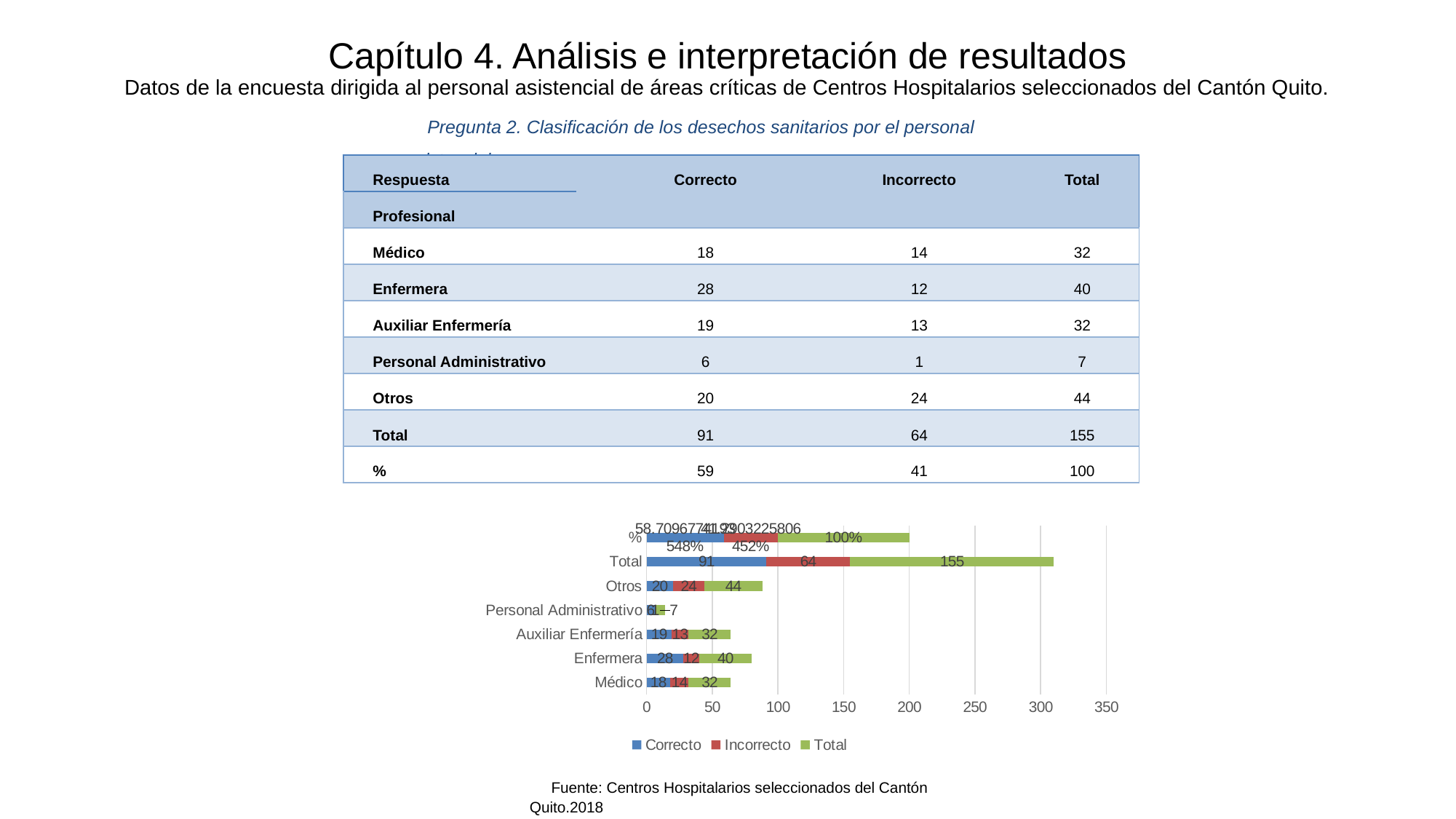
How many series does the chart legend list? 3 Which is larger in the chart: the Incorrecto value for Otros or the Incorrecto value for Médico? Otros What is the difference between the Correcto and Incorrecto values for Enfermera in the chart? 16 Among Médico, Enfermera, Auxiliar Enfermería, Personal Administrativo and Otros, which category has the lowest Correcto value in the chart? Personal Administrativo What is the Total value for Auxiliar Enfermería in the chart? 32 What is the Correcto value for the Total category in the chart? 91 What kind of chart is shown on the slide? bar chart What is the Incorrecto value for Otros in the chart? 24 Among Médico, Enfermera, Auxiliar Enfermería, Personal Administrativo and Otros, which category has the highest Total value in the chart? Otros What is the Correcto value for Enfermera in the chart? 28 Which series is shown in green in the chart? Total How many categories are shown on the chart's vertical axis? 7